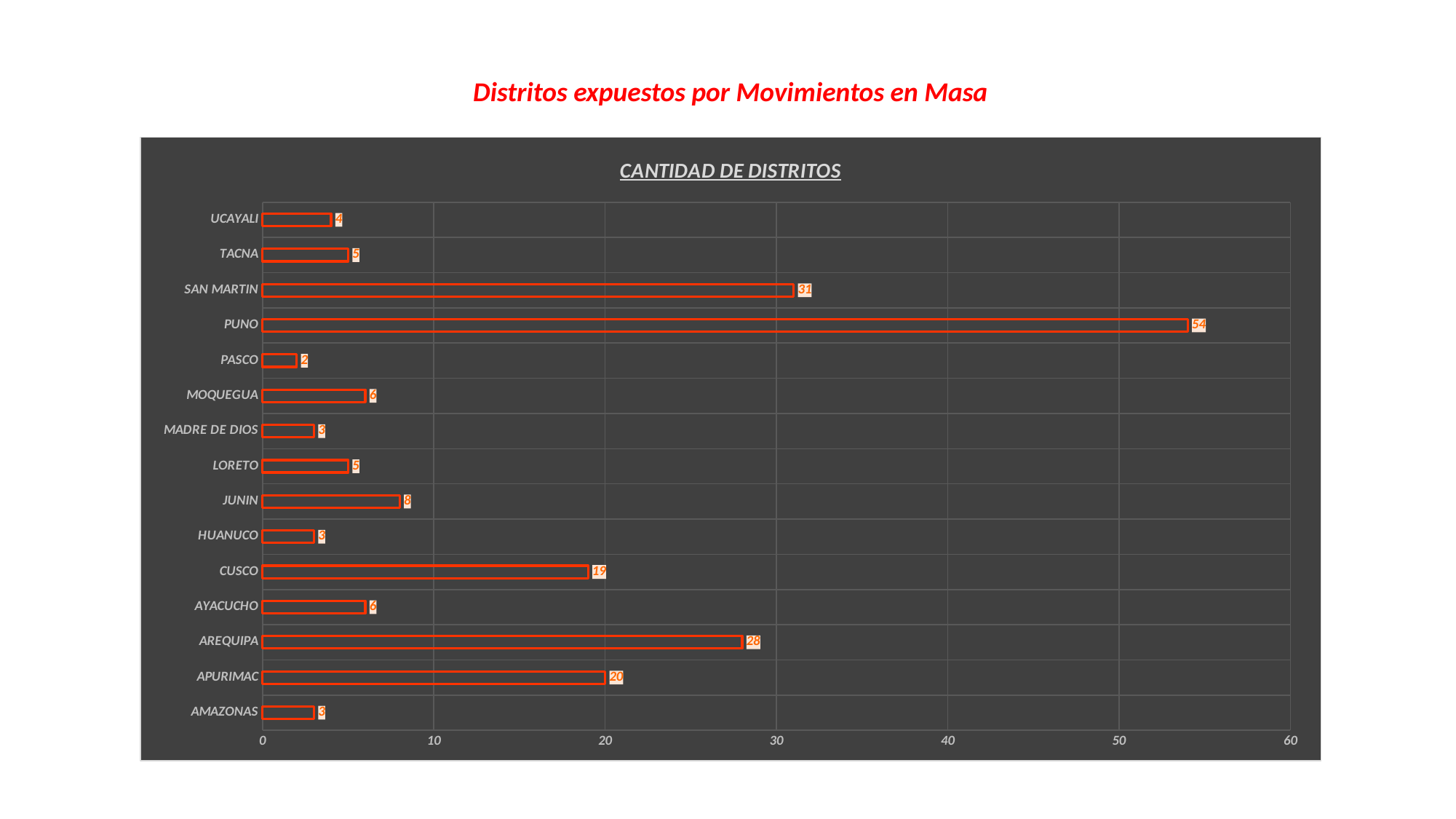
What kind of chart is shown on the slide? bar chart What is the value for AREQUIPA? 28 Which category has the lowest value? PASCO What is the difference between the values for AREQUIPA and APURIMAC? 8 What is the difference between the values for PUNO and SAN MARTIN? 23 Which category has the highest value? PUNO What is the value for CUSCO? 19 Is the value for SAN MARTIN greater or less than 30? greater Which is larger, the value for APURIMAC or the value for CUSCO? APURIMAC What is the title of the chart? CANTIDAD DE DISTRITOS What is the value for PUNO? 54 How many categories are shown on the chart? 15